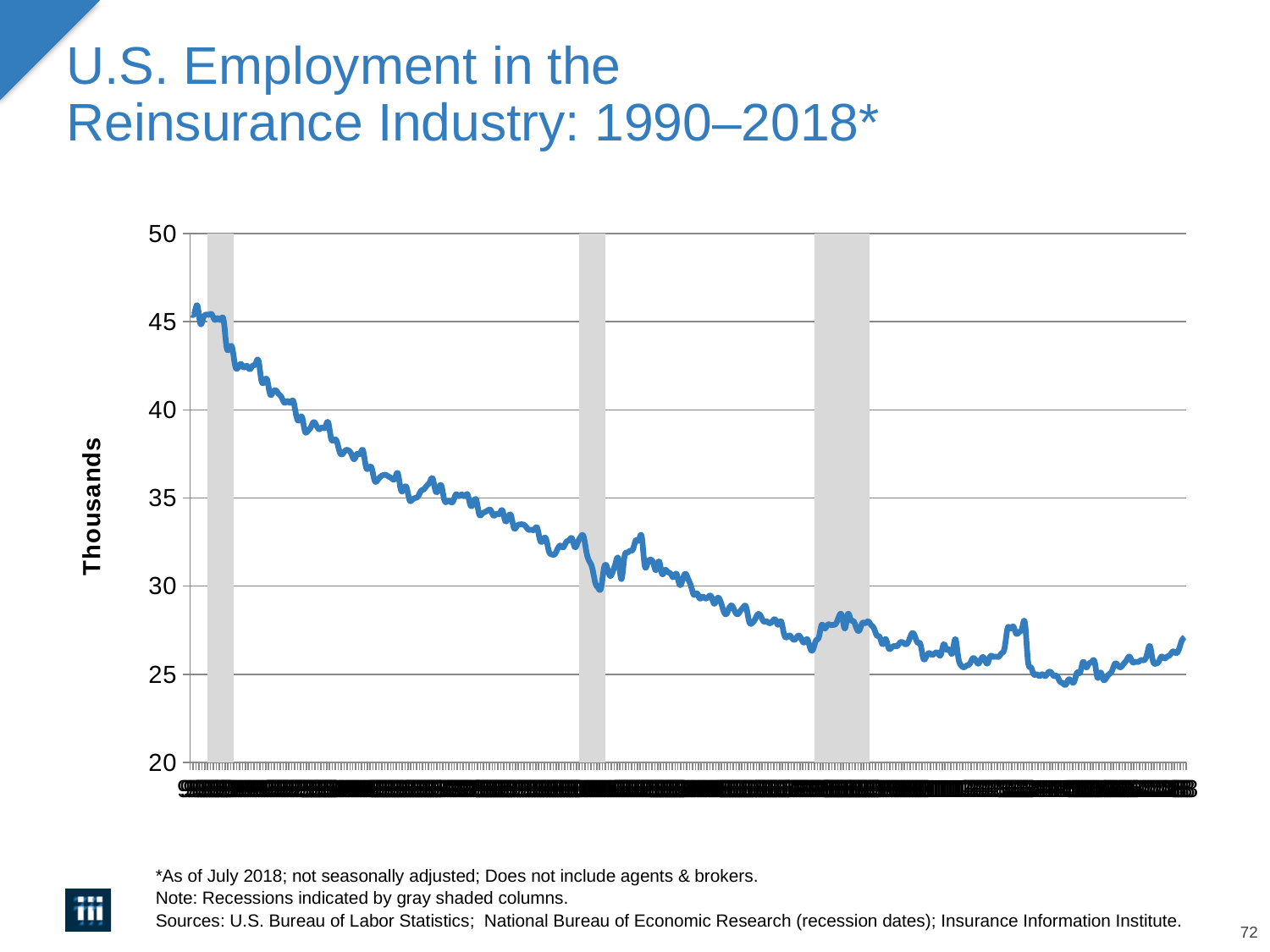
Is the lowest point of the employment line greater or less than 25 thousand? less Is the employment value at the start of the series (1990) greater or less than 40 thousand? greater Overall, does U.S. reinsurance industry employment rise or fall from 1990 to 2018 along the x axis? fall Is the employment value at the end of the series (2018) greater or less than 30 thousand? less What is the highest value shown on the vertical axis? 50 How many gray shaded recession columns appear on the chart? 3 What kind of chart is shown on the slide? line chart Is the employment value at the start of the series greater or less than the value at the end of the series? greater What is the label on the vertical axis of the chart? Thousands